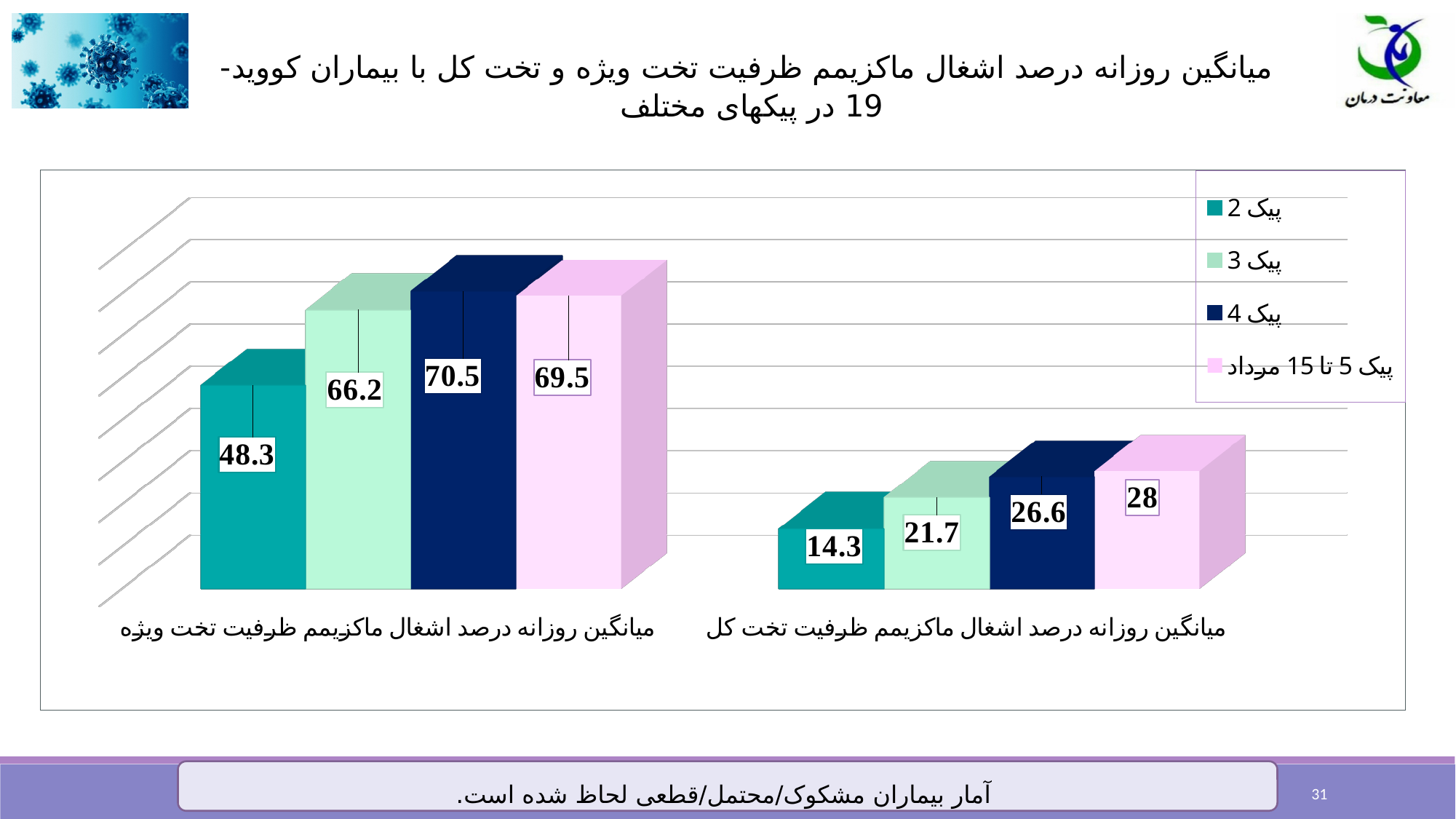
What is the difference between the پیک 5 تا 15 مرداد and پیک 3 values in the category میانگین روزانه درصد اشغال ماکزیمم ظرفیت تخت کل? 6.3 How many series does the legend list? 4 Which series has the highest value in the category میانگین روزانه درصد اشغال ماکزیمم ظرفیت تخت ویژه? پیک 4 What is the value for پیک 2 in the category میانگین روزانه درصد اشغال ماکزیمم ظرفیت تخت ویژه? 48.3 What is the difference between the پیک 4 and پیک 2 values in the category میانگین روزانه درصد اشغال ماکزیمم ظرفیت تخت ویژه? 22.2 What kind of chart is shown on the slide? Bar chart What is the value for پیک 5 تا 15 مرداد in the category میانگین روزانه درصد اشغال ماکزیمم ظرفیت تخت کل? 28 In the category میانگین روزانه درصد اشغال ماکزیمم ظرفیت تخت کل, which is larger: پیک 3 or پیک 4? پیک 4 Which series has the lowest value in the category میانگین روزانه درصد اشغال ماکزیمم ظرفیت تخت کل? پیک 2 What is the value for پیک 4 in the category میانگین روزانه درصد اشغال ماکزیمم ظرفیت تخت کل? 26.6 How many categories are shown on the x axis of the chart? 2 What is the value for پیک 3 in the category میانگین روزانه درصد اشغال ماکزیمم ظرفیت تخت ویژه? 66.2